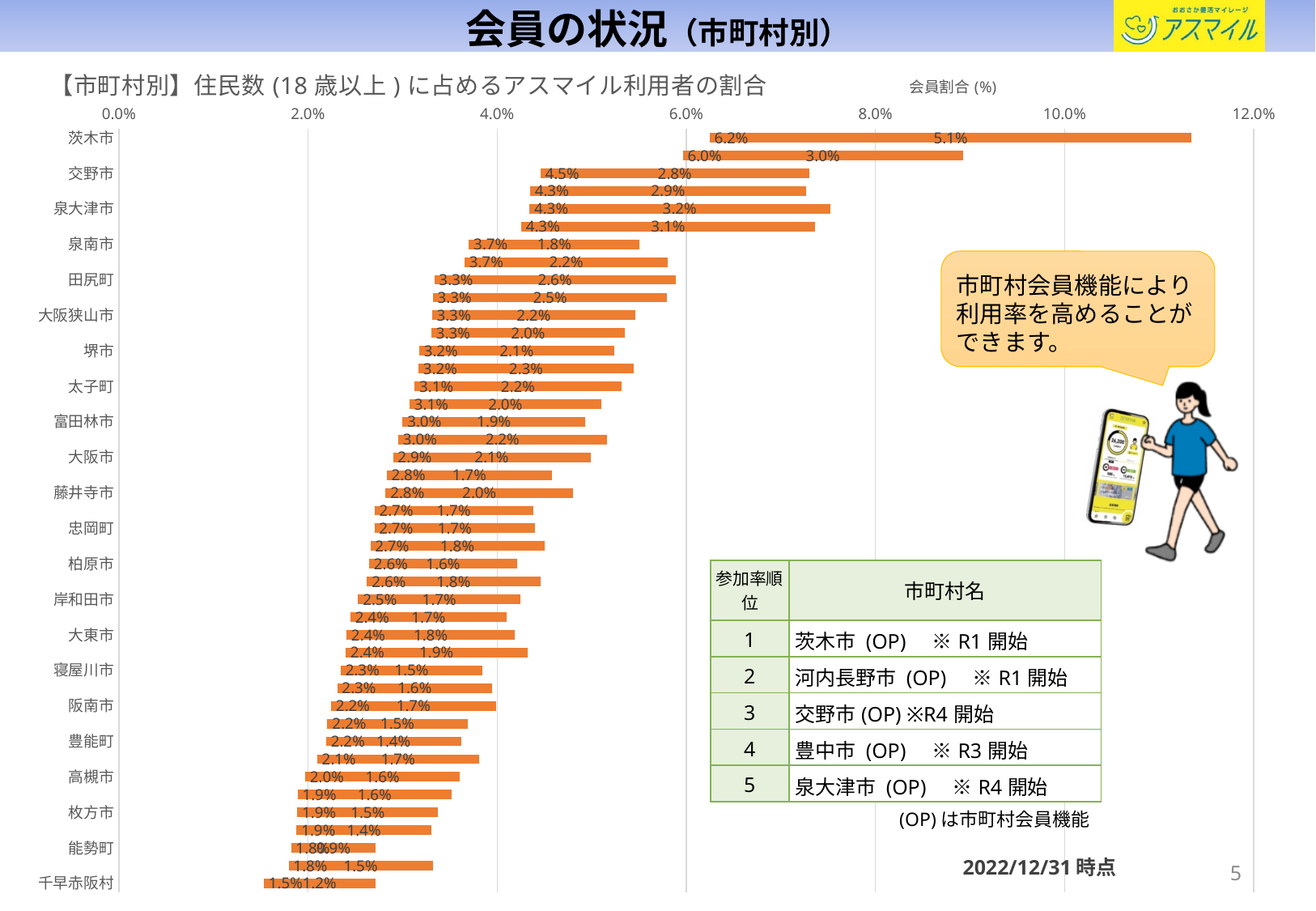
What is the value of the second segment of the bar for 茨木市? 5.1% What is the value of the first segment of the bar for 交野市? 4.5% What is the total of the stacked bar for 交野市? 7.3% What is the value of the second segment of the bar for 泉大津市? 3.2% Is the total bar length for 茨木市 greater or less than 10.0%? greater Which municipality has the longest bar in the chart? 茨木市 What is the value of the first (left) segment of the bar for 茨木市? 6.2% Which has the larger first segment, 泉大津市 or 泉南市? 泉大津市 What is the title of the horizontal axis of the chart? 会員割合 (%) What is the difference between the first segment of 茨木市 (6.2%) and the first segment of 交野市 (4.5%)? 1.7% What is the total of the stacked bar for 茨木市? 11.3% What kind of chart is shown on the slide? Bar chart (stacked horizontal)